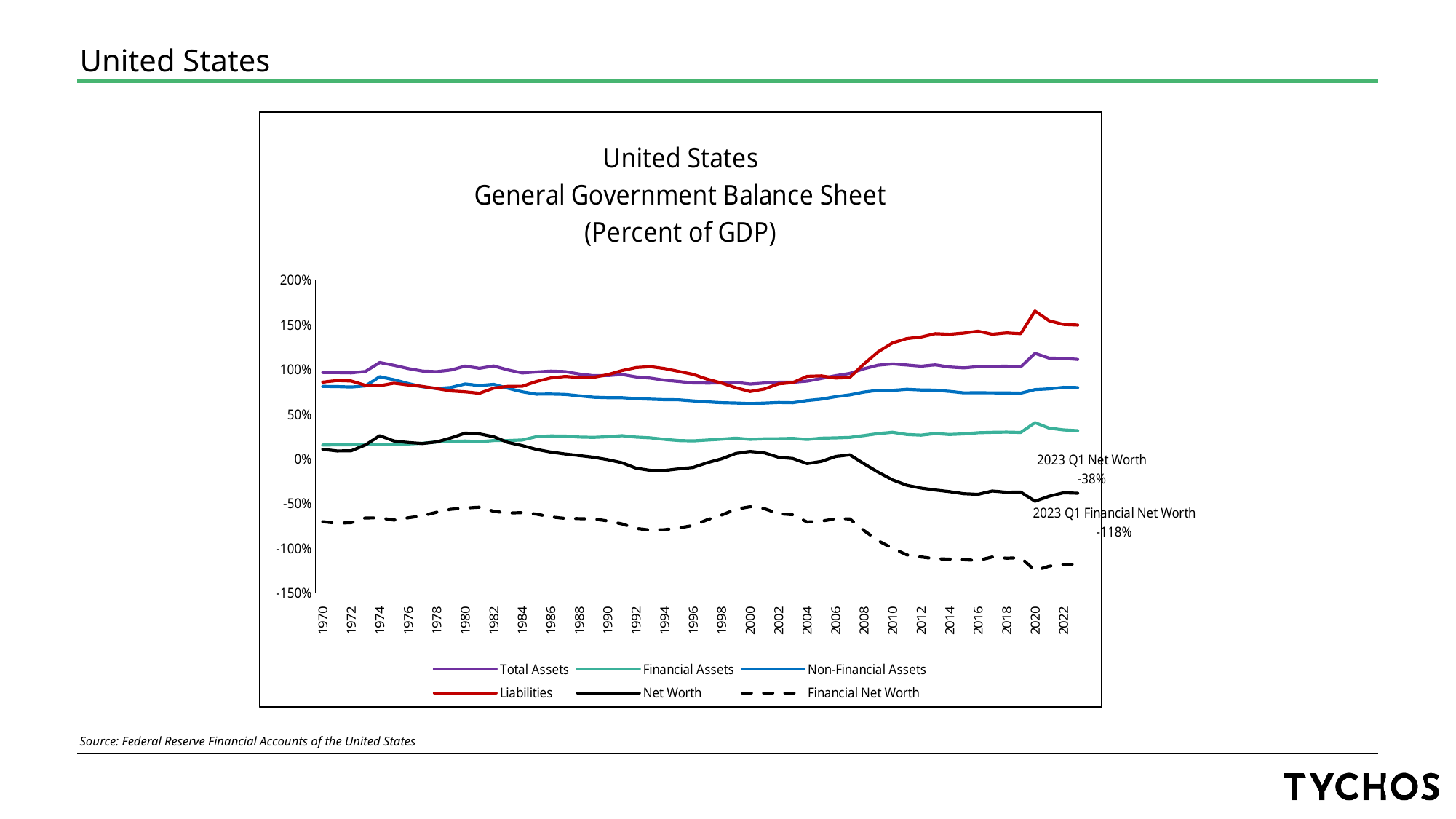
In 2022, which is higher, Liabilities or Total Assets? Liabilities What kind of chart is shown on the slide? line chart Which series has the lowest values throughout the chart? Financial Net Worth Is the value for Liabilities in 2020 greater or less than 150%? greater What is the 2023 Q1 Financial Net Worth value labelled on the chart? -118% What is the 2023 Q1 Net Worth value labelled on the chart? -38% Is the value for Financial Assets in 1970 greater or less than 50%? less Which series has the highest value in 2022? Liabilities Do Liabilities rise or fall between 2008 and 2012? rise What source is cited for the chart? Federal Reserve Financial Accounts of the United States What is the difference between the labelled 2023 Q1 Net Worth and 2023 Q1 Financial Net Worth values? 80 percentage points How many series does the legend list? 6